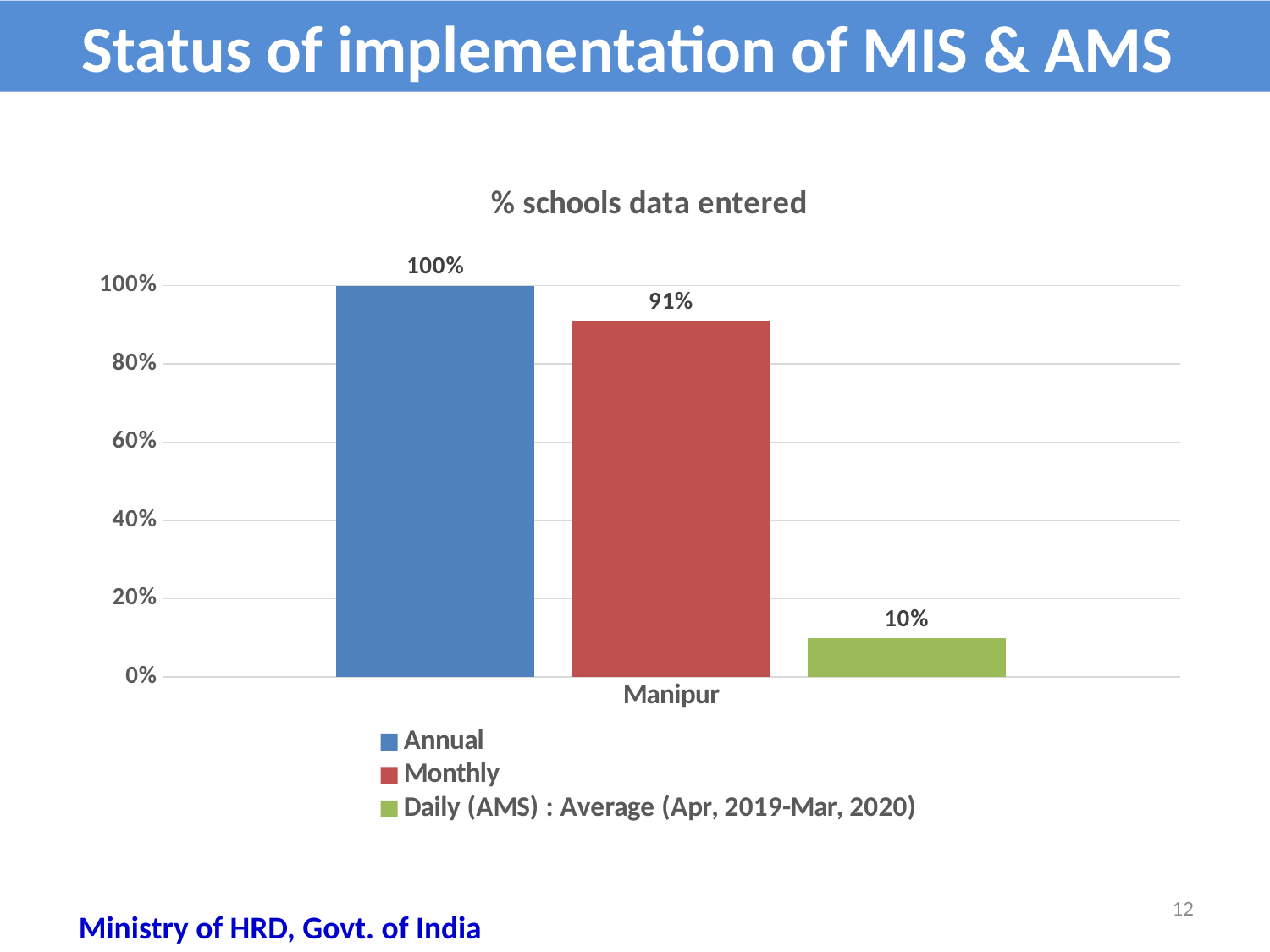
Which is larger, the Monthly value or the Daily (AMS) value? Monthly What is the title of the chart? % schools data entered What is the difference between the Annual and Monthly values? 9% Which series has the lowest value? Daily (AMS) : Average (Apr, 2019-Mar, 2020) What is the value for Annual in the chart? 100% What kind of chart is shown on the slide? bar chart Is the value for Daily (AMS) greater or less than 20%? less Which series has the highest value? Annual What is the value for Monthly in the chart? 91% What is the difference between the Monthly and Daily (AMS) values? 81% How many series does the legend list? 3 What is the value for Daily (AMS) : Average (Apr, 2019-Mar, 2020)? 10%